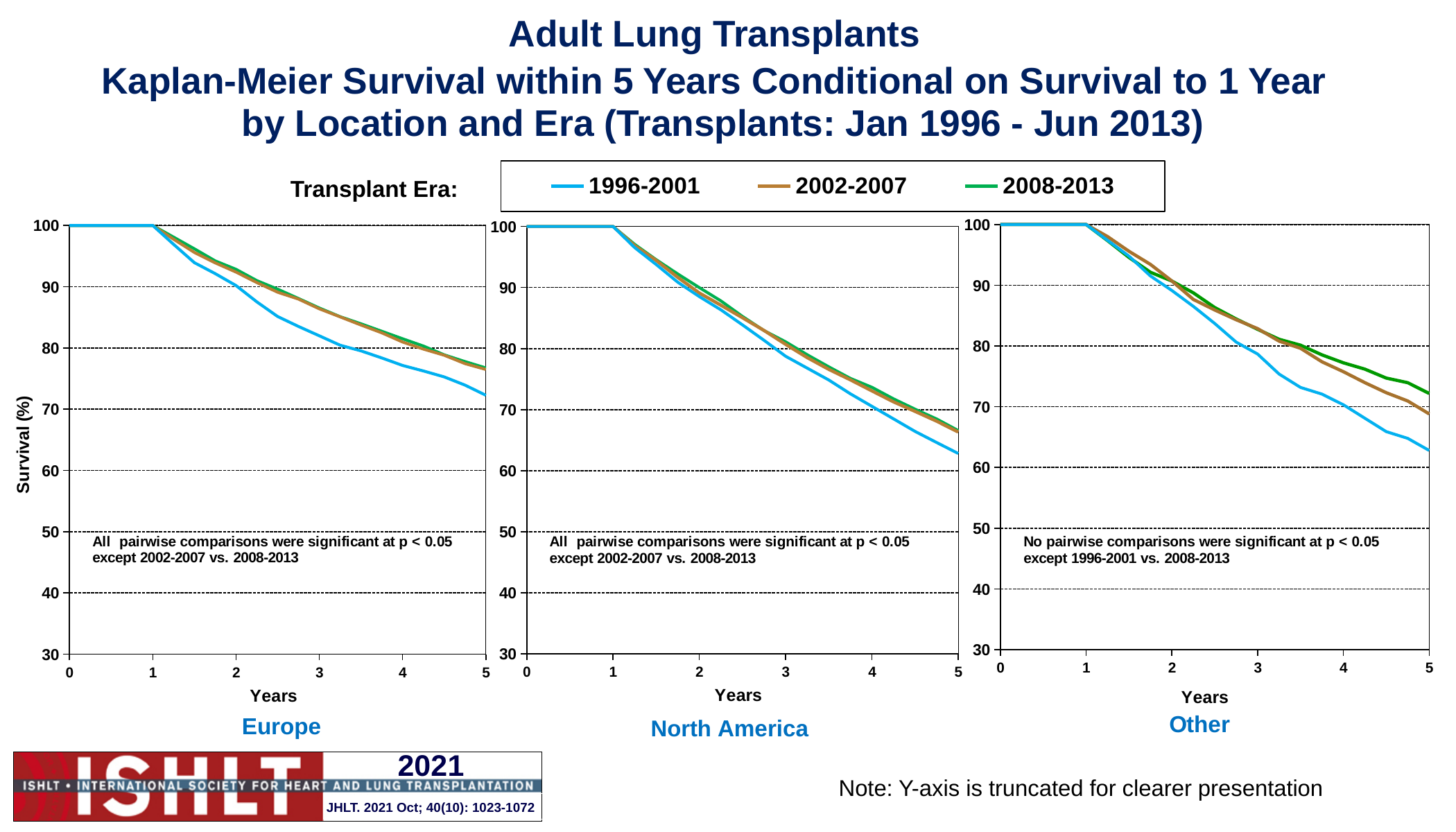
In the Europe chart, at year 5, which series has the higher survival: 1996-2001 or 2008-2013? 2008-2013 In the Europe chart, do the survival values rise or fall as years increase from 1 to 5? Fall What is the label on the y-axis of the Europe chart? Survival (%) In the Other chart, which series has the highest survival at year 5? 2008-2013 What kind of chart is the Europe chart? Line chart How many series does the legend list for the charts? 3 In the Europe chart, what is the survival value for the 1996-2001 series at year 1? 100 In the Other chart, which series has the lowest survival at year 5? 1996-2001 In the North America chart, is the value for the 1996-2001 series at year 5 greater or less than 70? less How many charts are shown on the slide? 3 In the Europe chart, is the value for the 1996-2001 series at year 5 greater or less than 80? less In the Other chart, is the value for the 2008-2013 series at year 5 greater or less than 70? greater